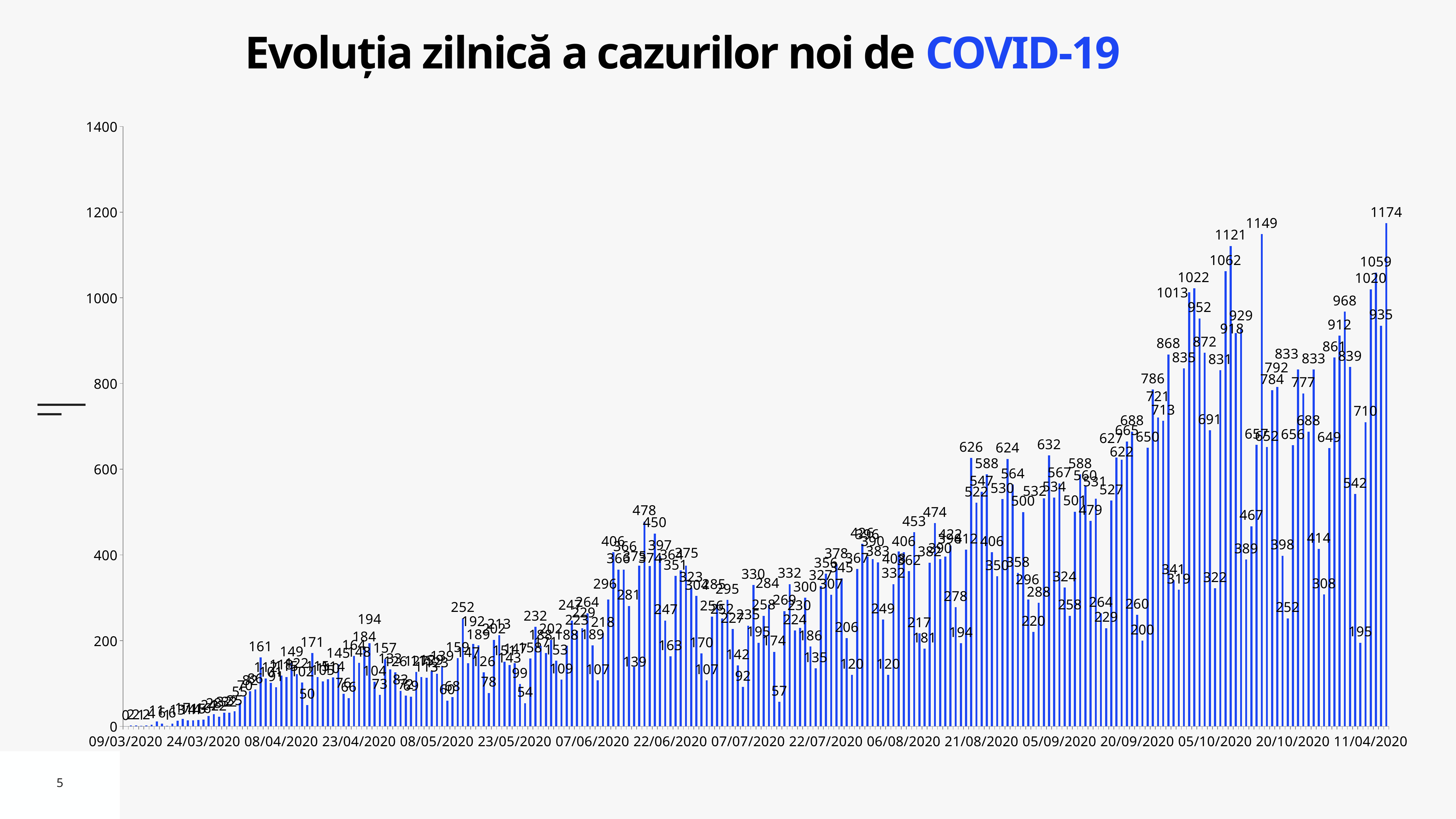
What is the maximum value shown on the vertical axis? 1400 What kind of chart is shown on the slide? bar chart Overall, do the daily values rise or fall from left to right along the x axis? rise What is the value of the last bar, at the 11/04/2020 tick? 1174 What is the difference between the bars labeled 1121 and 1062? 59 Which is larger, the bar labeled 1121 or the bar labeled 1062? 1121 What is the highest daily value labeled on the chart? 1174 What is the value of the first bar, for 09/03/2020? 0 What is the difference between the two highest labeled values, 1174 and 1149? 25 Is the value of the last bar, at 11/04/2020, greater or less than 1000? greater Is the value of the first bar, at 09/03/2020, greater or less than 200? less What is the title of the chart? Evoluția zilnică a cazurilor noi de COVID-19